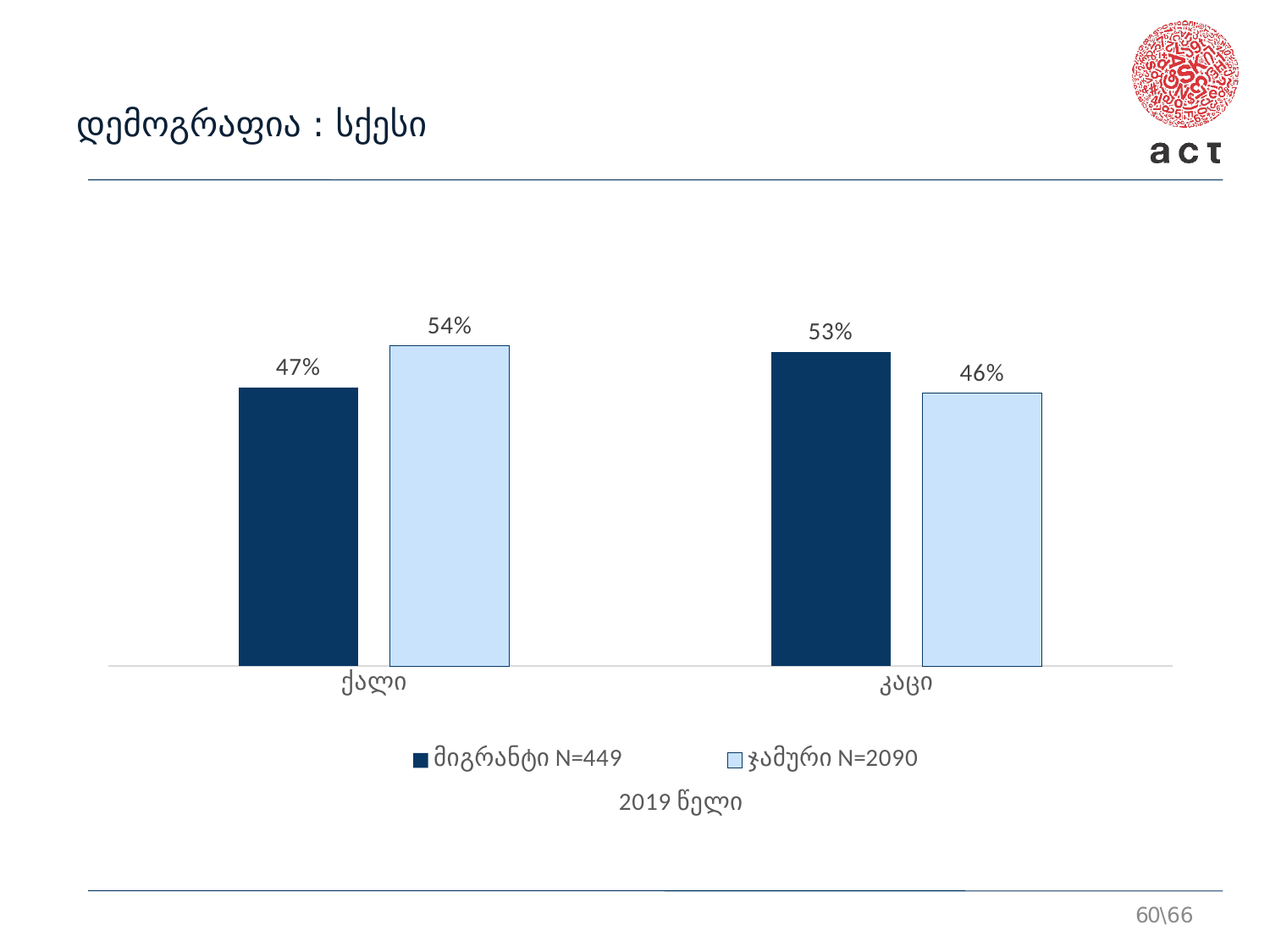
What is the value for ჯამური N=2090 in the კაცი category? 46% How many categories are shown on the x axis? 2 What is the value for მიგრანტი N=449 in the ქალი category? 47% What is the difference between the ჯამური N=2090 and მიგრანტი N=449 values in the ქალი category? 7% How many series does the legend list? 2 Which bar has the highest value on the chart? ჯამური N=2090 for ქალი (54%) Which bar has the lowest value on the chart? ჯამური N=2090 for კაცი (46%) In the კაცი category, which series has the larger value, მიგრანტი N=449 or ჯამური N=2090? მიგრანტი N=449 What kind of chart is shown on the slide? Bar chart What is the value for ჯამური N=2090 in the ქალი category? 54% What is the value for მიგრანტი N=449 in the კაცი category? 53% What is the title shown below the chart legend? 2019 წელი